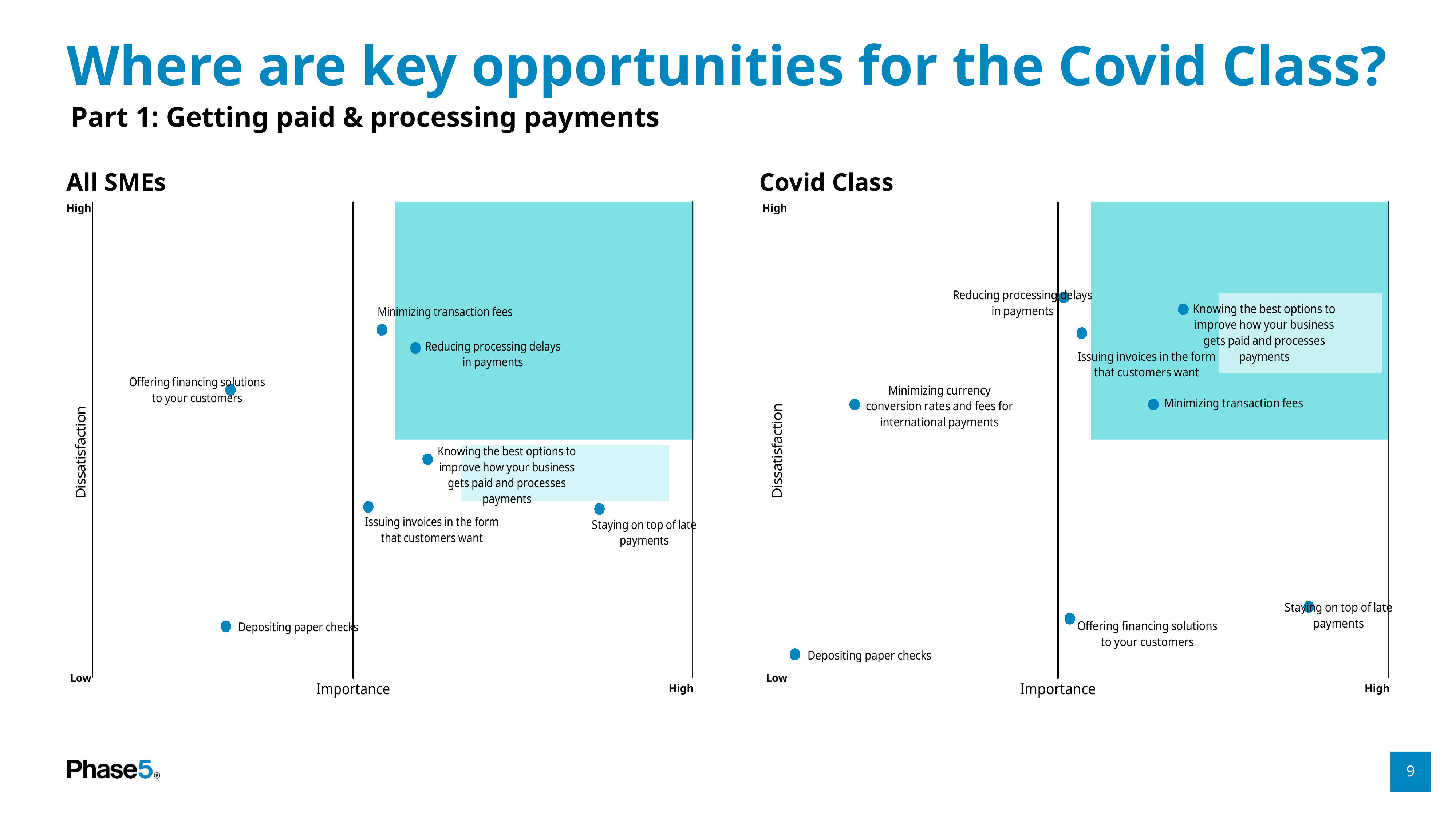
What are the x-axis and y-axis labels on the charts? Importance (x-axis) and Dissatisfaction (y-axis) In the Covid Class chart, which has higher importance: Minimizing currency conversion rates and fees for international payments or Minimizing transaction fees? Minimizing transaction fees In the All SMEs chart, which item has the highest dissatisfaction? Minimizing transaction fees In the All SMEs chart, how many data points are plotted? 7 In the Covid Class chart, how many data points are plotted? 8 In the Covid Class chart, which item has the lowest importance? Depositing paper checks In the All SMEs chart, which has higher dissatisfaction: Offering financing solutions to your customers or Depositing paper checks? Offering financing solutions to your customers What kind of chart is used for the All SMEs and Covid Class panels? Scatter chart In the Covid Class chart, which item has the lowest dissatisfaction? Depositing paper checks In the Covid Class chart, which item has the highest importance? Staying on top of late payments In the All SMEs chart, which item has the highest importance? Staying on top of late payments In the All SMEs chart, which item has the lowest dissatisfaction? Depositing paper checks